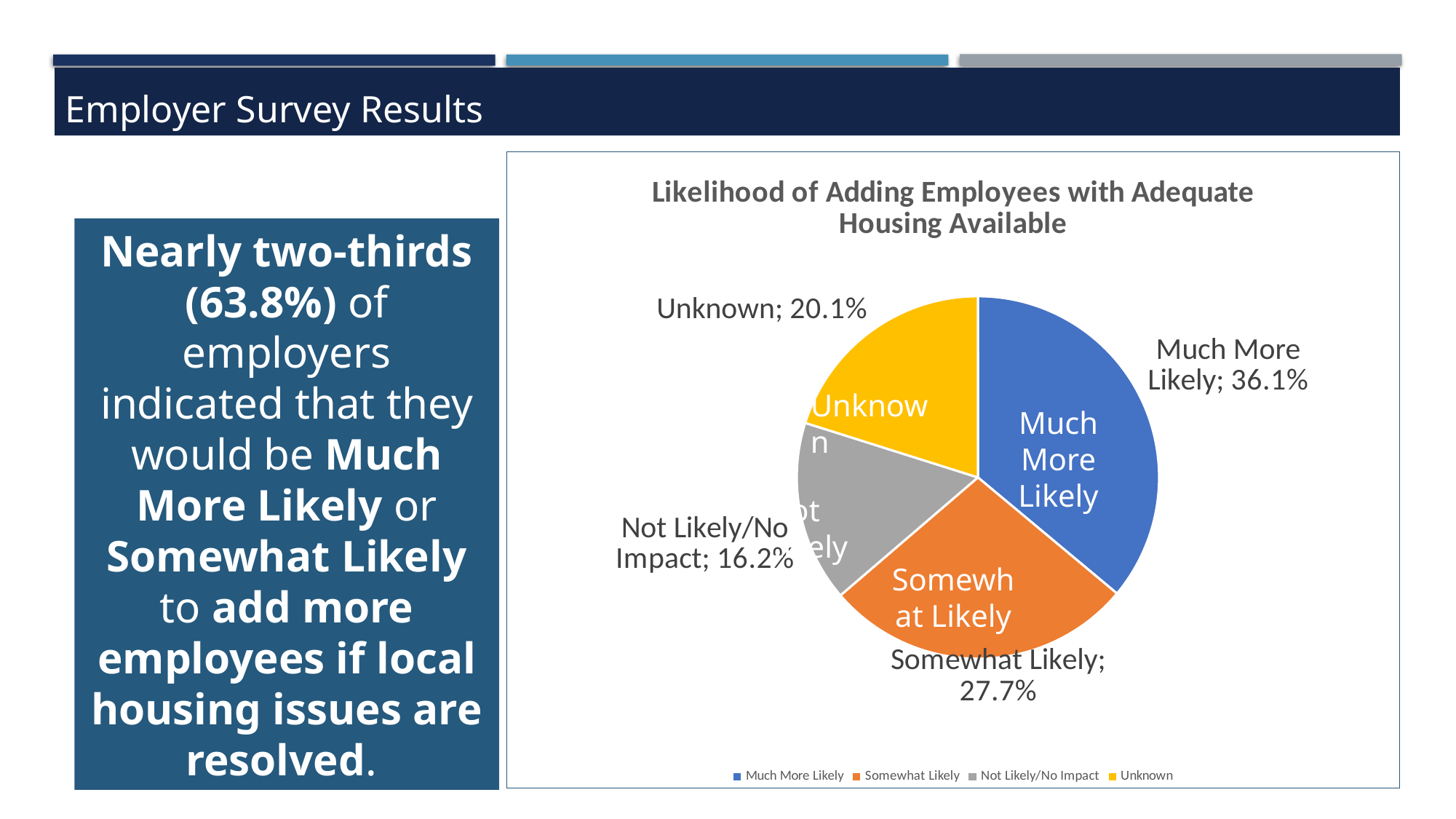
What percentage of the pie is the Unknown slice? 20.1% Which category has the smallest share of the pie? Not Likely/No Impact What is the title of the chart? Likelihood of Adding Employees with Adequate Housing Available What colour is the Somewhat Likely slice? Orange What percentage of the pie is the Somewhat Likely slice? 27.7% What is the difference in percentage points between the Much More Likely and Somewhat Likely slices? 8.4 How many slices does the pie chart have? 4 What percentage of the pie is the Much More Likely slice? 36.1% What kind of chart is shown on the slide? Pie chart Which category has the largest share of the pie? Much More Likely Which slice is larger, Unknown or Not Likely/No Impact? Unknown What percentage of the pie is the Not Likely/No Impact slice? 16.2%